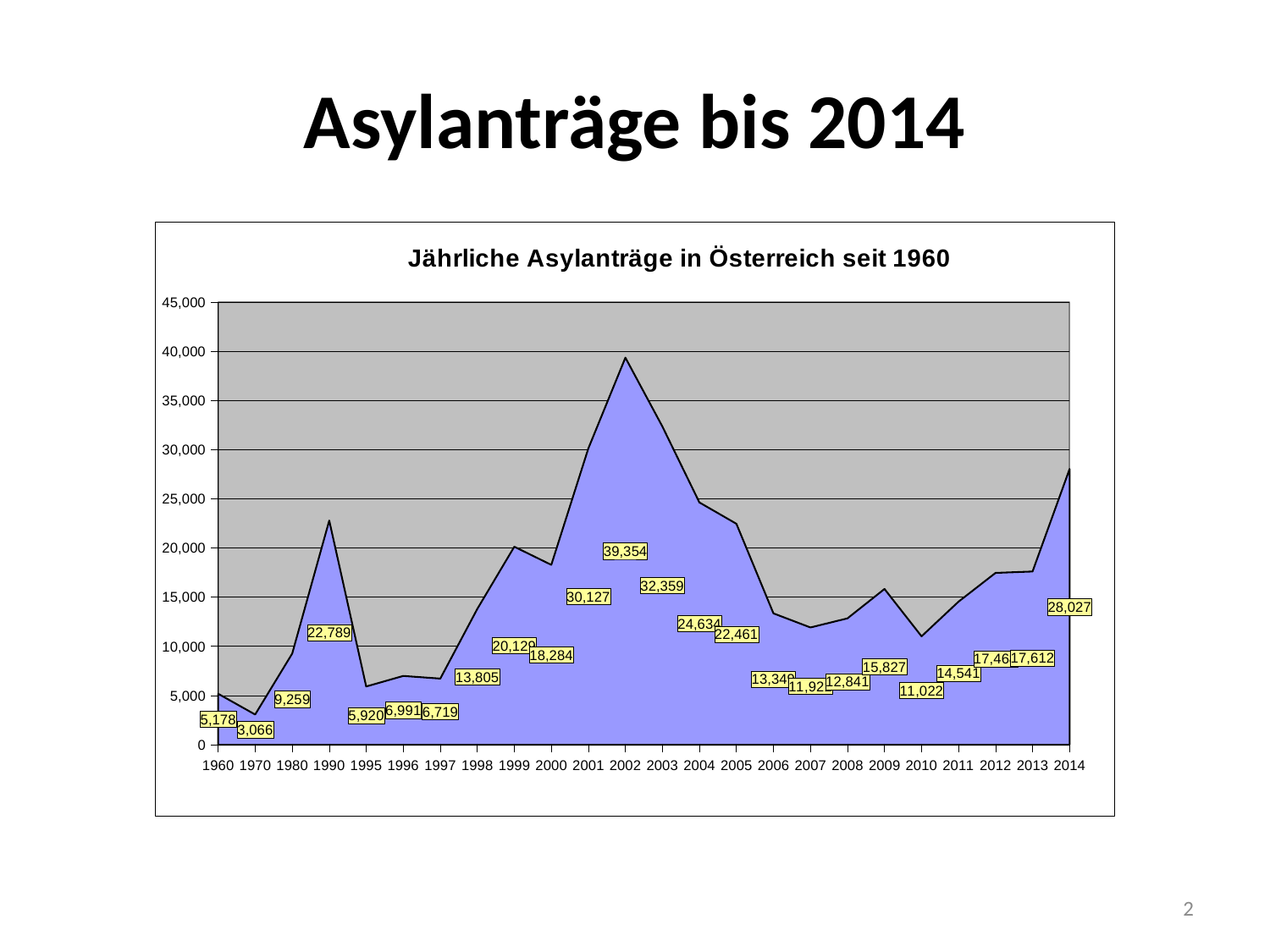
What is the value for 2002? 39,354 Which is larger, the value for 2004 or the value for 2005? 2004 How many years are plotted on the x axis? 24 What is the difference between the values for 2002 and 2003? 6,995 Which year has the lowest value? 1970 What is the value for 2014? 28,027 What is the value for 1990? 22,789 Which year has the highest value? 2002 What is the value for 1970? 3,066 Is the value for 2001 greater or less than 25,000? greater What kind of chart is shown? Area chart What is the title of the chart? Jährliche Asylanträge in Österreich seit 1960